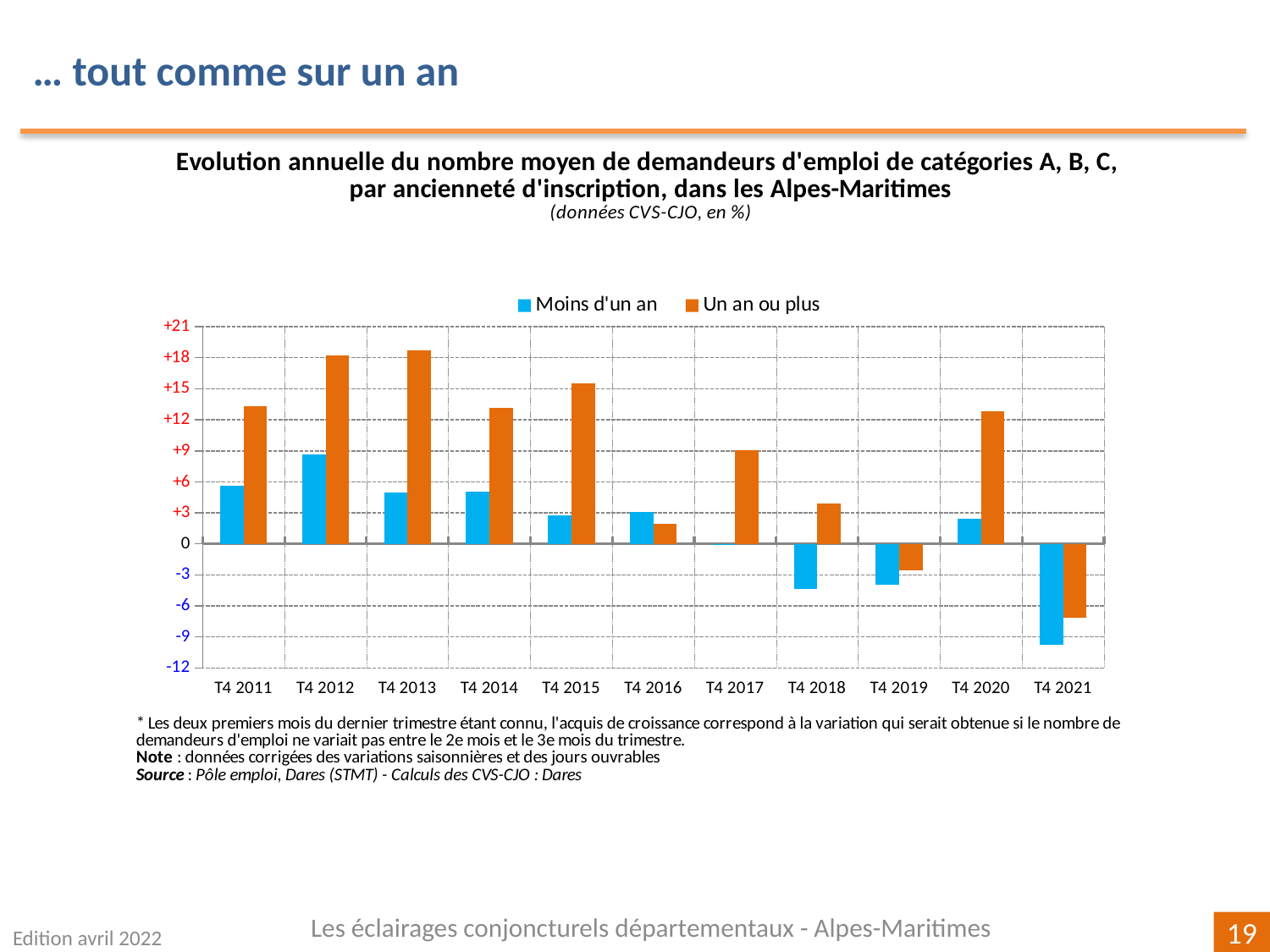
Which quarter has the lowest value for the 'Un an ou plus' series? T4 2021 In T4 2015, which series has the larger value, 'Moins d'un an' or 'Un an ou plus'? Un an ou plus Is the value for 'Moins d'un an' in T4 2021 greater or less than -6? less Which quarter has the highest value for the 'Moins d'un an' series? T4 2012 How many series does the legend list? 2 Which colour represents the 'Un an ou plus' series in the legend? orange Which quarter has the lowest value for the 'Moins d'un an' series? T4 2021 Is the value for 'Un an ou plus' in T4 2020 greater or less than +9? greater How many quarters (categories) are shown on the x axis? 11 In T4 2016, which series has the larger value, 'Moins d'un an' or 'Un an ou plus'? Moins d'un an Is the value for 'Un an ou plus' in T4 2012 greater or less than +15? greater What kind of chart is shown on the slide? bar chart